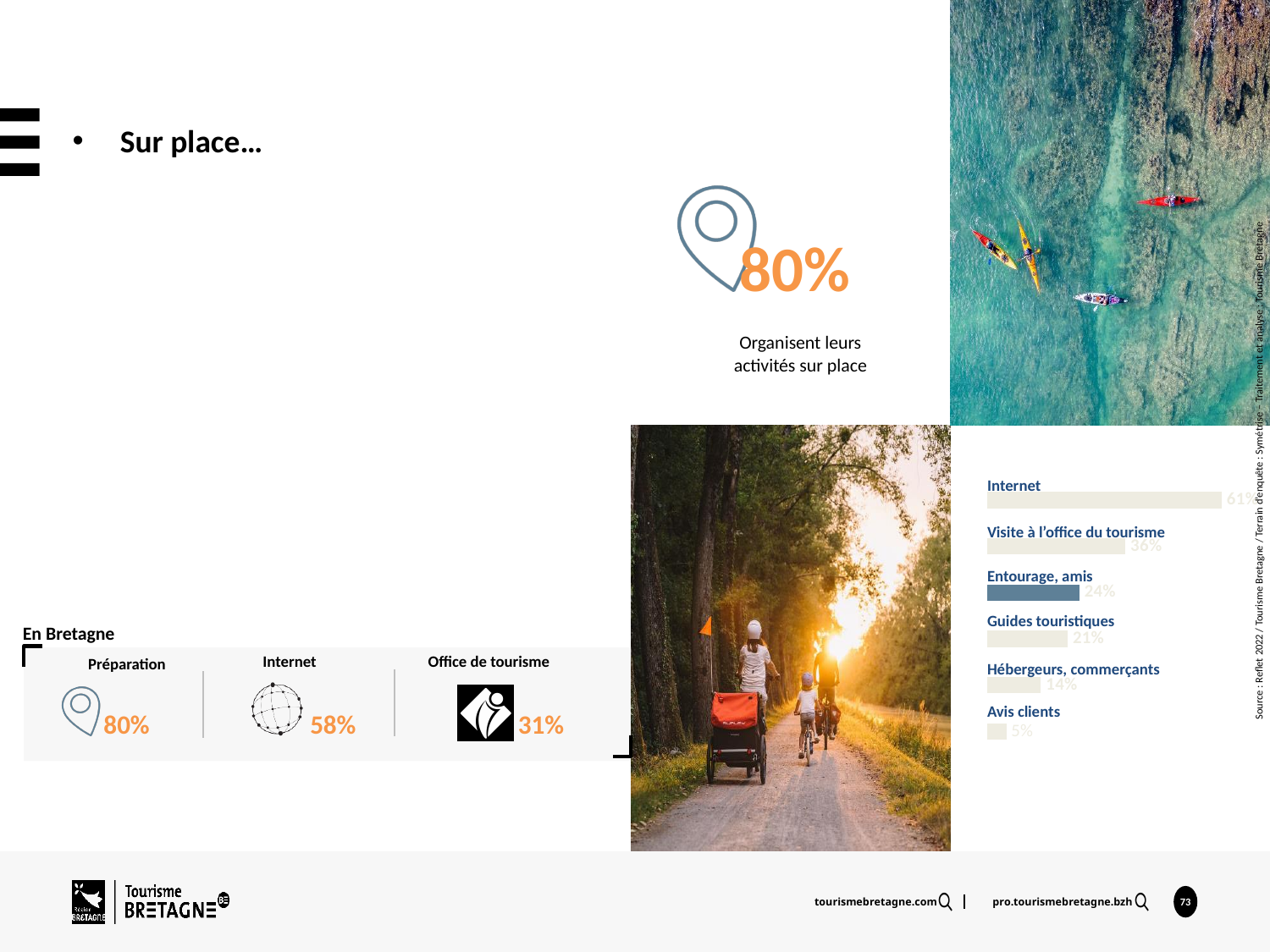
In the bar chart on the right, what is the value for Avis clients? 5% In the bar chart on the right, which is larger: Guides touristiques or Hébergeurs, commerçants? Guides touristiques In the bar chart on the right, what is the value for Hébergeurs, commerçants? 14% In the bar chart on the right, which category has the lowest value? Avis clients In the bar chart on the right, what is the value for Internet? 61% How many categories does the bar chart on the right show? 6 In the bar chart on the right, what is the difference between Internet and Visite à l'office du tourisme? 25% In the bar chart on the right, what is the value for Entourage, amis? 24% In the bar chart on the right, what is the difference between Entourage, amis and Avis clients? 19% What kind of chart is shown on the right of the slide? Bar chart In the bar chart on the right, which category has the highest value? Internet In the bar chart on the right, what is the value for Guides touristiques? 21%